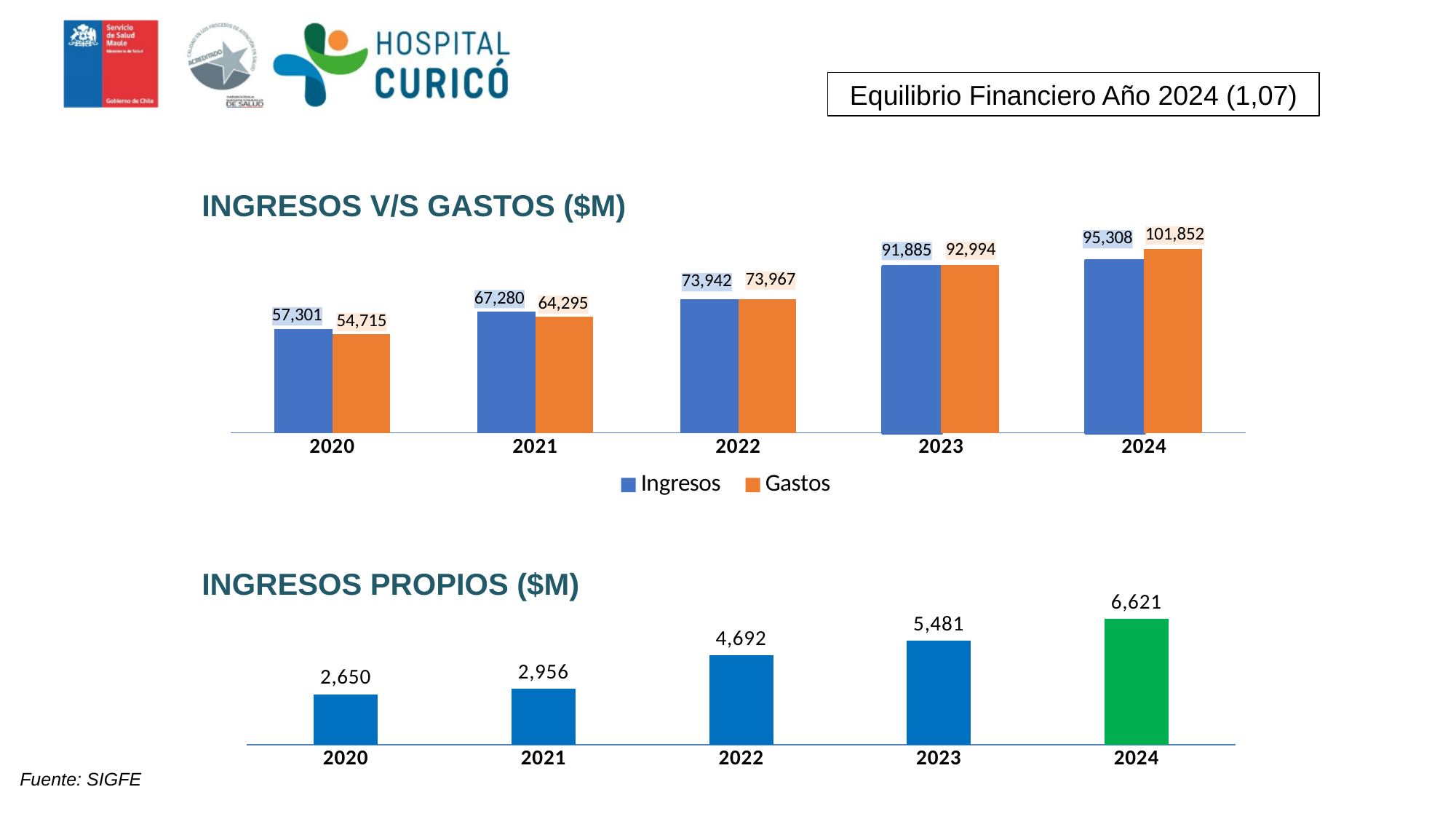
In the INGRESOS V/S GASTOS ($M) chart, which year has the highest Gastos value? 2024 What type of chart is the INGRESOS PROPIOS ($M) chart? Bar chart How many series does the legend of the INGRESOS V/S GASTOS ($M) chart list? 2 In the INGRESOS V/S GASTOS ($M) chart, what is the difference between Gastos and Ingresos in 2024? 6,544 In the INGRESOS PROPIOS ($M) chart, how many years are shown? 5 In the INGRESOS V/S GASTOS ($M) chart, what is the value of Gastos for 2024? 101,852 In the INGRESOS PROPIOS ($M) chart, what is the difference between the 2024 and 2020 values? 3,971 In the INGRESOS PROPIOS ($M) chart, what is the value for 2023? 5,481 In the INGRESOS V/S GASTOS ($M) chart, which is larger in 2021, Ingresos or Gastos? Ingresos In the INGRESOS V/S GASTOS ($M) chart, which year has the lowest Ingresos value? 2020 In the INGRESOS V/S GASTOS ($M) chart, what is the value of Ingresos for 2022? 73,942 In the INGRESOS PROPIOS ($M) chart, do the values rise or fall from 2020 to 2024? Rise